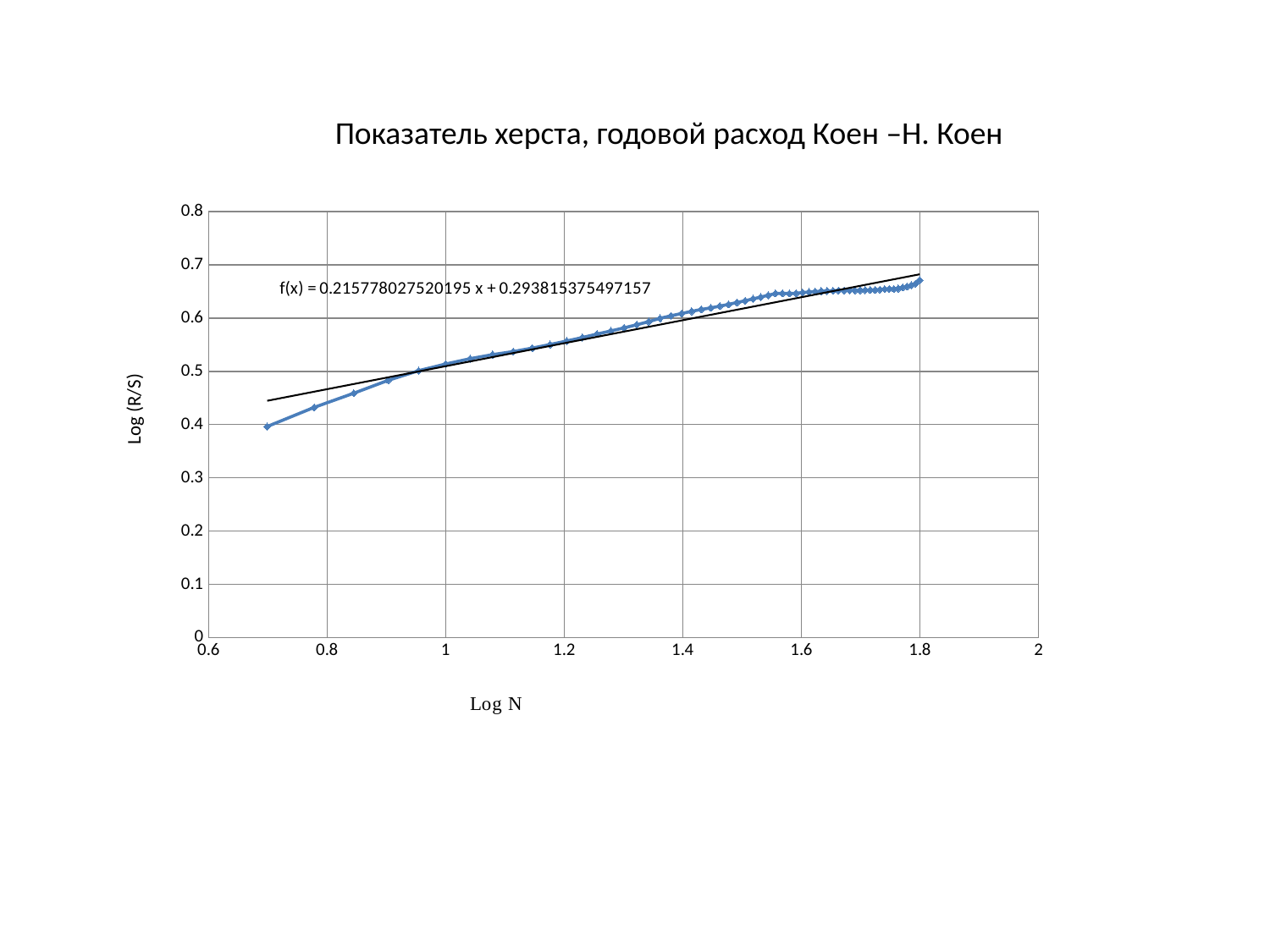
Is the Log (R/S) value at Log N = 0.8 greater or less than 0.5? less What is the slope of the fitted trendline f(x) shown on the chart? 0.215778027520195 Is the Log (R/S) value at Log N = 1.2 greater or less than 0.5? greater What is the intercept of the fitted trendline f(x) shown on the chart? 0.293815375497157 What kind of chart is shown on the slide? line chart Do the plotted Log (R/S) values rise or fall as Log N increases? rise What is the label of the vertical axis? Log (R/S) What is the title of the chart? Показатель херста, годовой расход Коен –Н. Коен Is the Log (R/S) value at Log N = 1.8 greater or less than 0.6? greater What is the maximum value shown on the horizontal axis? 2 What is the maximum value shown on the vertical axis? 0.8